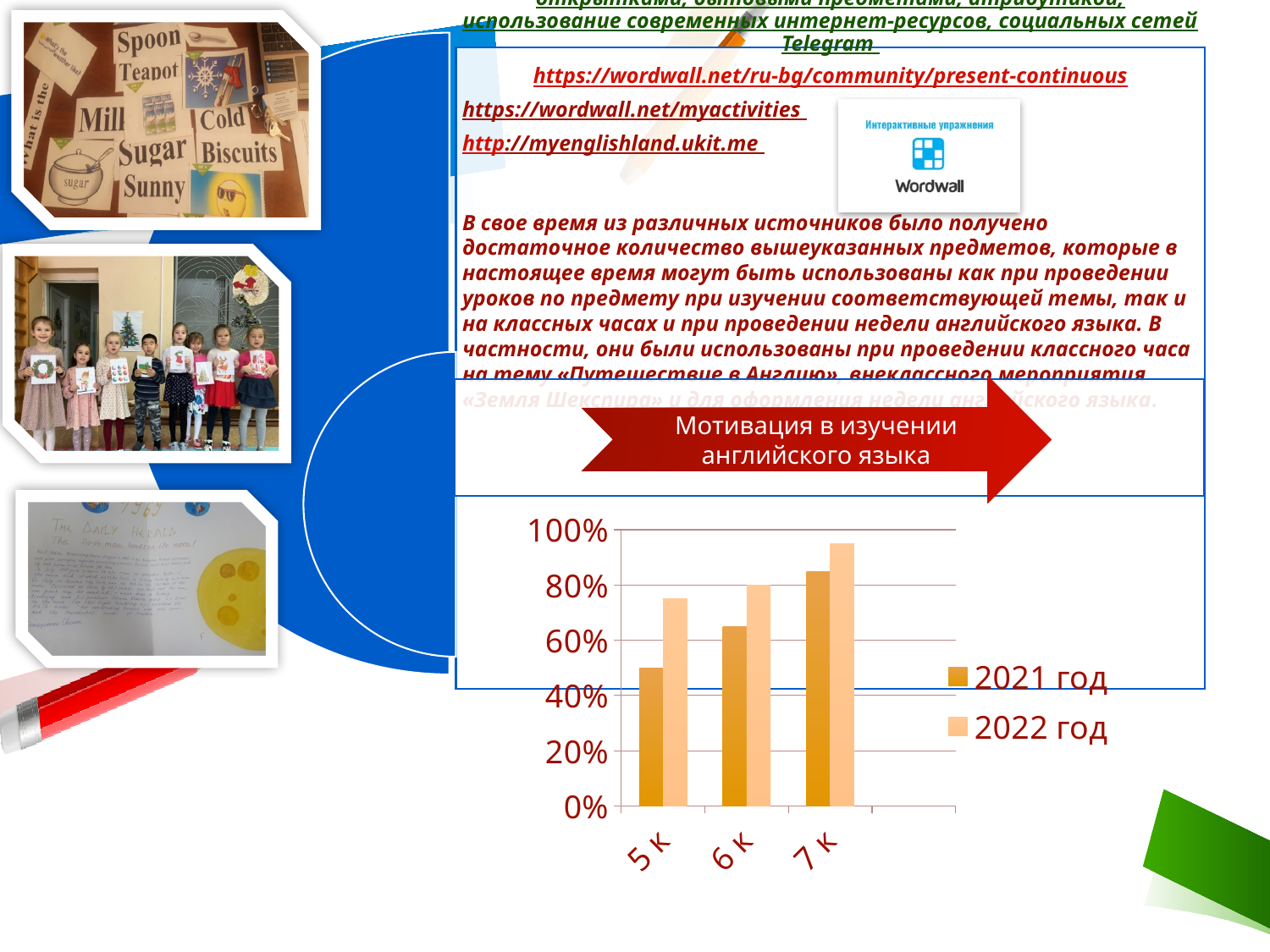
Is the value for 6 к in the 2021 год series greater or less than 80%? less Which category has the highest value for the 2022 год series? 7 к What are the two entries listed in the chart legend? 2021 год and 2022 год How many series does the chart legend list? 2 Which category has the lowest value for the 2021 год series? 5 к Do the values of the 2021 год series rise or fall from 5 к to 7 к? rise For 5 к, which series has the larger value, 2021 год or 2022 год? 2022 год Is the value for 6 к in the 2022 год series greater or less than 60%? greater Is the value for 5 к in the 2021 год series greater or less than 40%? greater How many categories are shown on the x axis of the chart? 3 What kind of chart is shown on the slide? bar chart